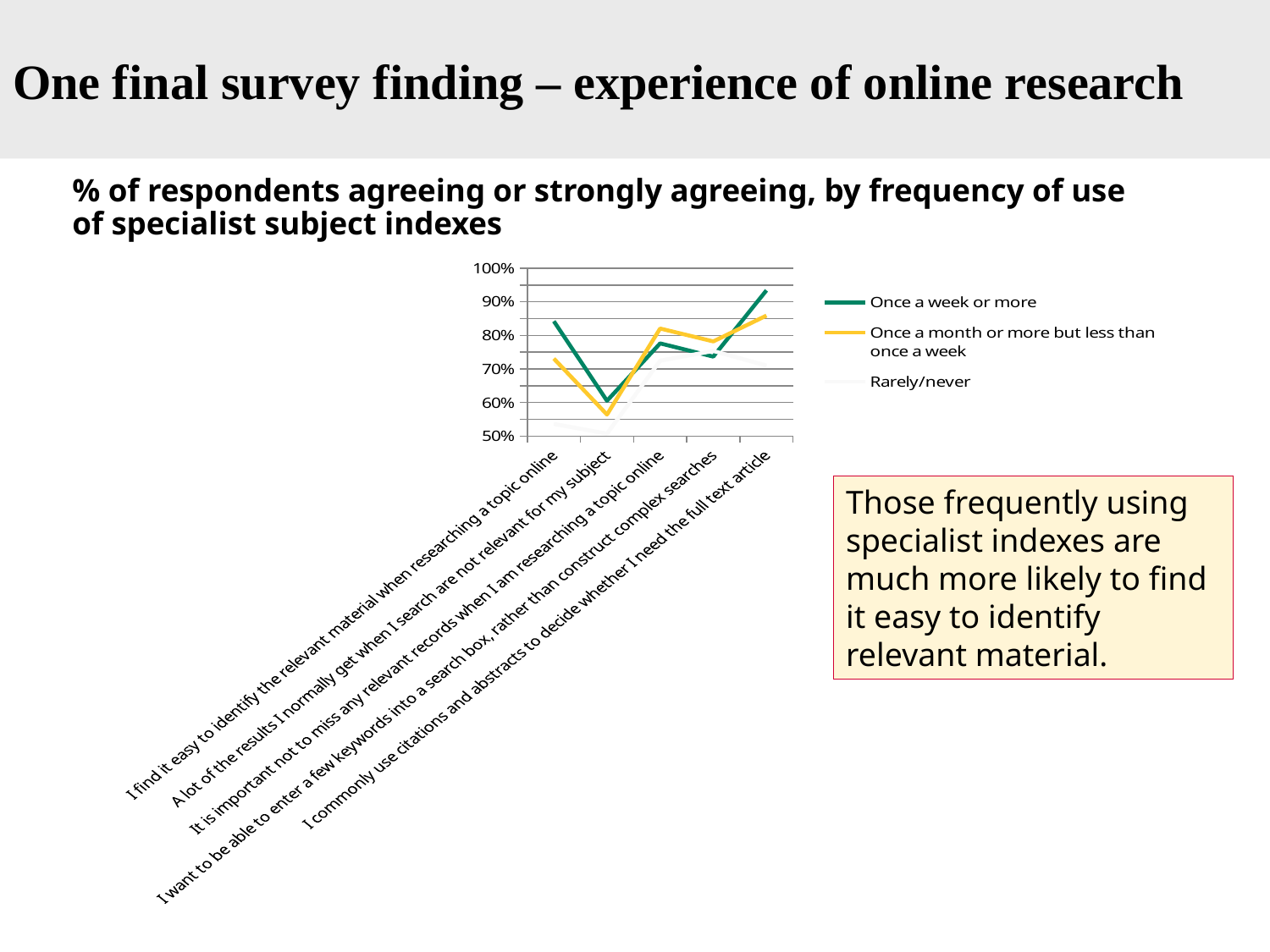
For which statement is the 'Once a week or more' series at its highest? I commonly use citations and abstracts to decide whether I need the full text article For 'It is important not to miss any relevant records when I am researching a topic online', which series is higher: 'Once a week or more' or 'Once a month or more but less than once a week'? Once a month or more but less than once a week Is the 'Once a month or more but less than once a week' value for 'A lot of the results I normally get when I search are not relevant for my subject' greater or less than 60%? less For which statement is the 'Once a month or more but less than once a week' series at its lowest? A lot of the results I normally get when I search are not relevant for my subject How many statements (categories) are plotted along the x axis of the chart? 5 For which statement is the 'Once a week or more' series at its lowest? A lot of the results I normally get when I search are not relevant for my subject Is the 'Once a week or more' value for 'I find it easy to identify the relevant material when researching a topic online' greater or less than 80%? greater For 'I find it easy to identify the relevant material when researching a topic online', which series is higher: 'Once a week or more' or 'Once a month or more but less than once a week'? Once a week or more What kind of chart is shown on the slide? Line chart Which series is drawn in green in the chart? Once a week or more How many series does the chart's legend list? 3 Is the 'Once a week or more' value for 'I commonly use citations and abstracts to decide whether I need the full text article' greater or less than 90%? greater